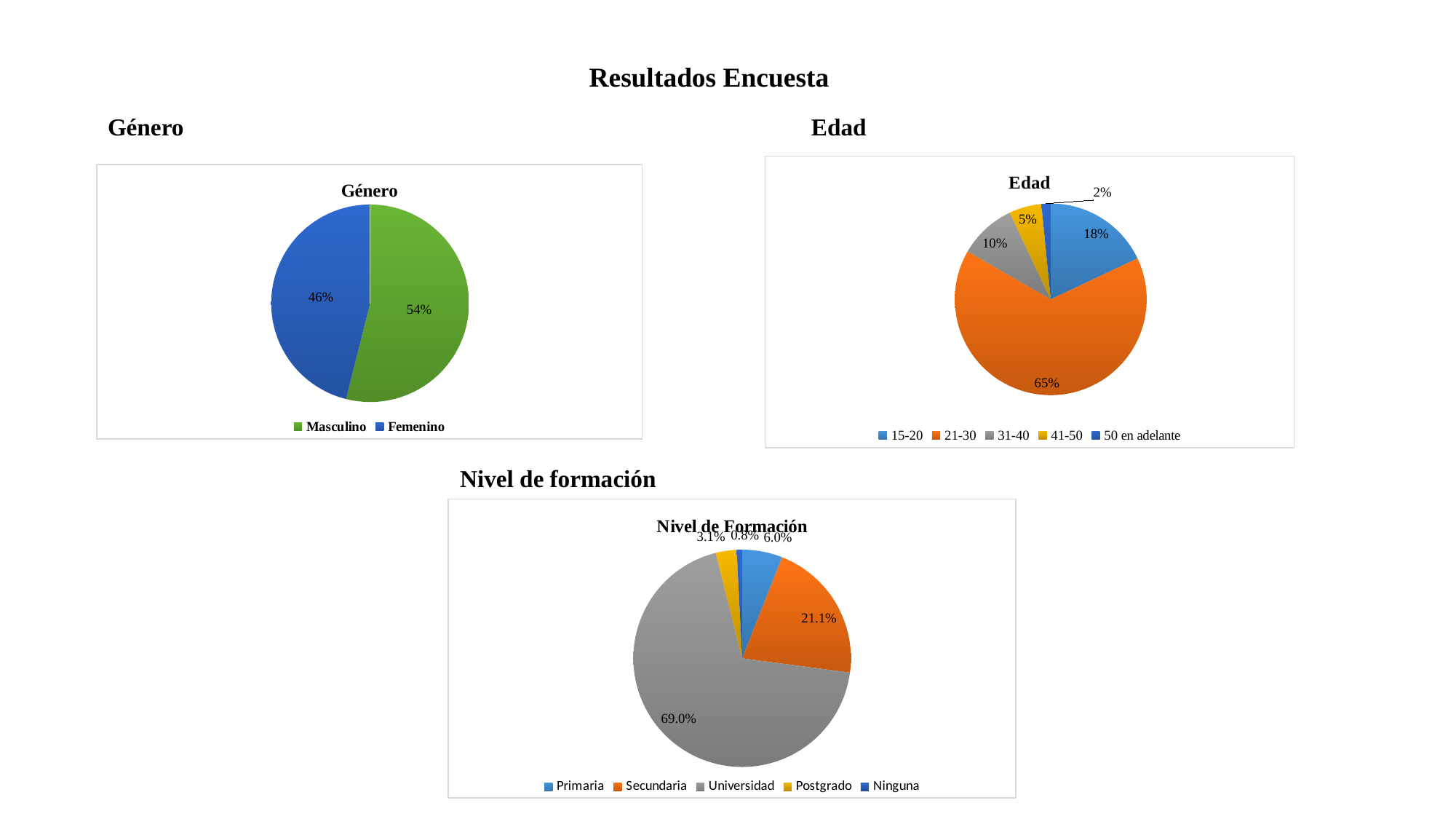
In the Edad chart, how many age groups does the legend list? 5 In the Edad chart, what is the value for the 21-30 group? 65% In the Nivel de Formación chart, what is the value for Universidad? 69.0% In the Edad chart, which age group has the smallest share? 50 en adelante What kind of chart is the Edad chart? Pie chart In the Género chart, what is the value for Femenino? 46% In the Edad chart, what is the difference between the 15-20 and 31-40 shares? 8% In the Género chart, which is larger, Masculino or Femenino? Masculino In the Nivel de Formación chart, which category has the largest share? Universidad In the Nivel de Formación chart, what is the value for Ninguna? 0.8% In the Nivel de Formación chart, what is the difference between Secundaria and Primaria? 15.1% In the Género chart, what share of the pie is Masculino? 54%